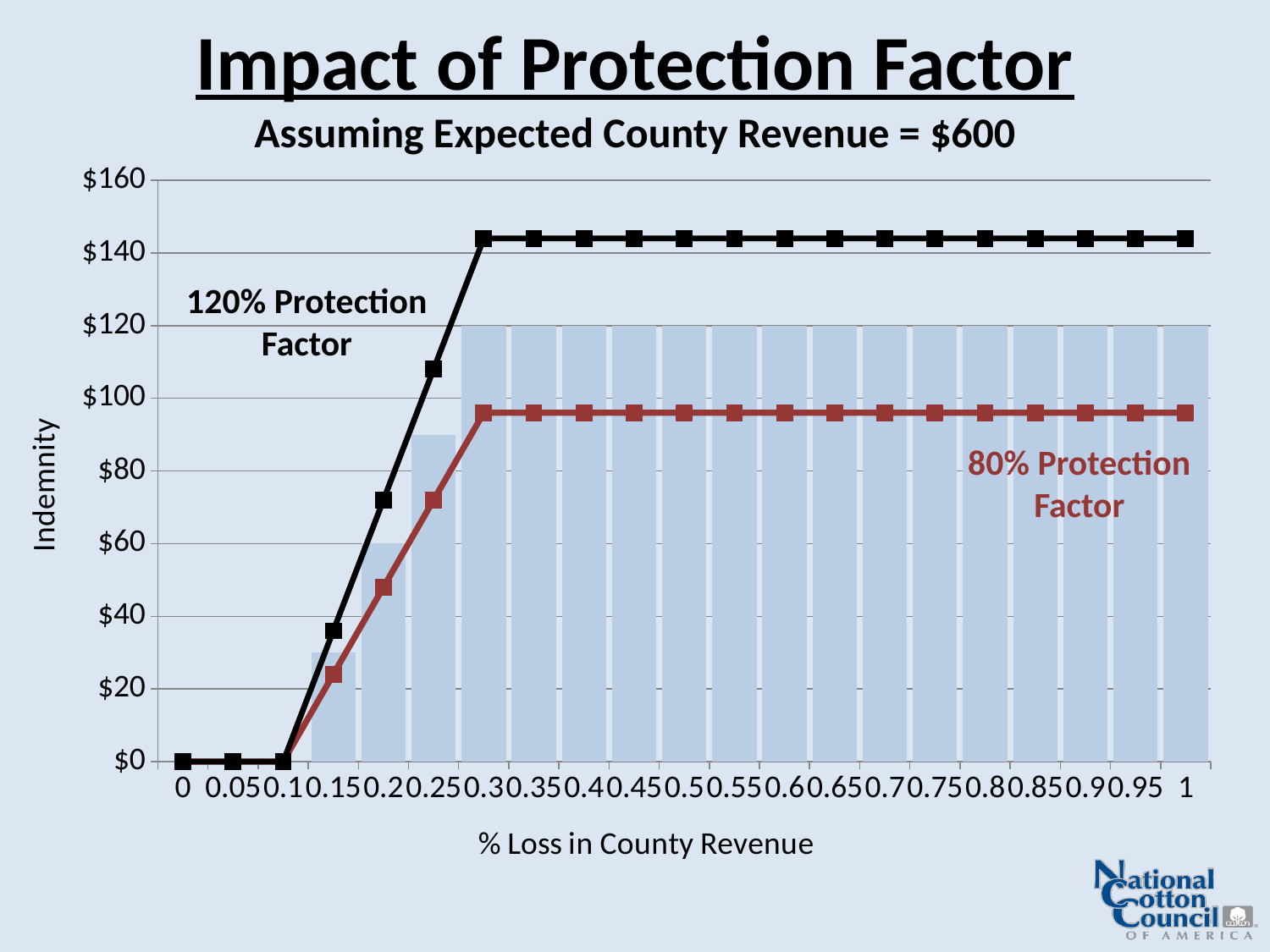
How many points are marked along the x axis from 0 to 1? 21 What is the indemnity for the 80% Protection Factor line at a 0.05 loss in county revenue? $0 What is the indemnity for the 120% Protection Factor line at a 0 loss in county revenue? $0 Is the value for the 120% Protection Factor line at a loss of 0.15 greater or less than $40? less What is the title of the chart? Impact of Protection Factor Does the 120% Protection Factor line rise or fall between a loss of 0.1 and a loss of 0.3? rise What is the label of the x axis? % Loss in County Revenue What kind of chart is shown on the slide? combination bar and line chart Is the value for the 80% Protection Factor line at a loss of 0.5 greater or less than $80? greater Is the value for the 120% Protection Factor line at a loss of 1 greater or less than $120? greater Which line reaches the higher plateau, the 120% Protection Factor or the 80% Protection Factor? 120% Protection Factor At a loss of 0.2, which line is higher, the 120% Protection Factor or the 80% Protection Factor? 120% Protection Factor